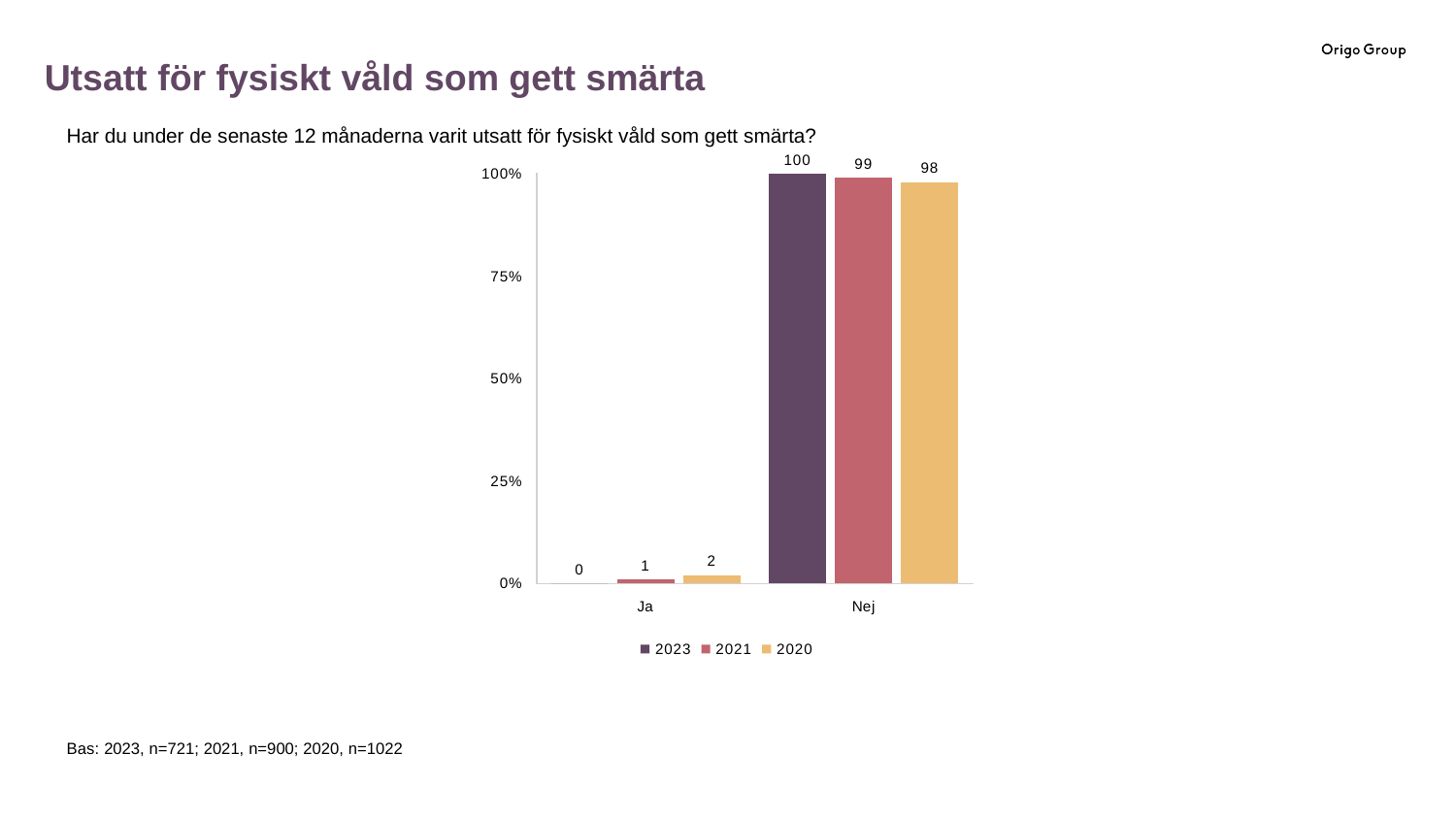
Which series has the lowest value in the Ja category? 2023 What is the difference between the 2023 and 2020 values in the Nej category? 2 Which is larger: the 2021 value for Ja or the 2020 value for Ja? 2020 What is the value for 2020 in the Ja category? 2 How many categories are shown on the x axis? 2 What is the value for 2021 in the Nej category? 99 What is the value for 2023 in the Ja category? 0 Which series has the highest value in the Nej category? 2023 How many series does the legend list? 3 What is the value for 2020 in the Nej category? 98 What kind of chart is shown on the slide? Bar chart Which series is shown in yellow in the legend? 2020